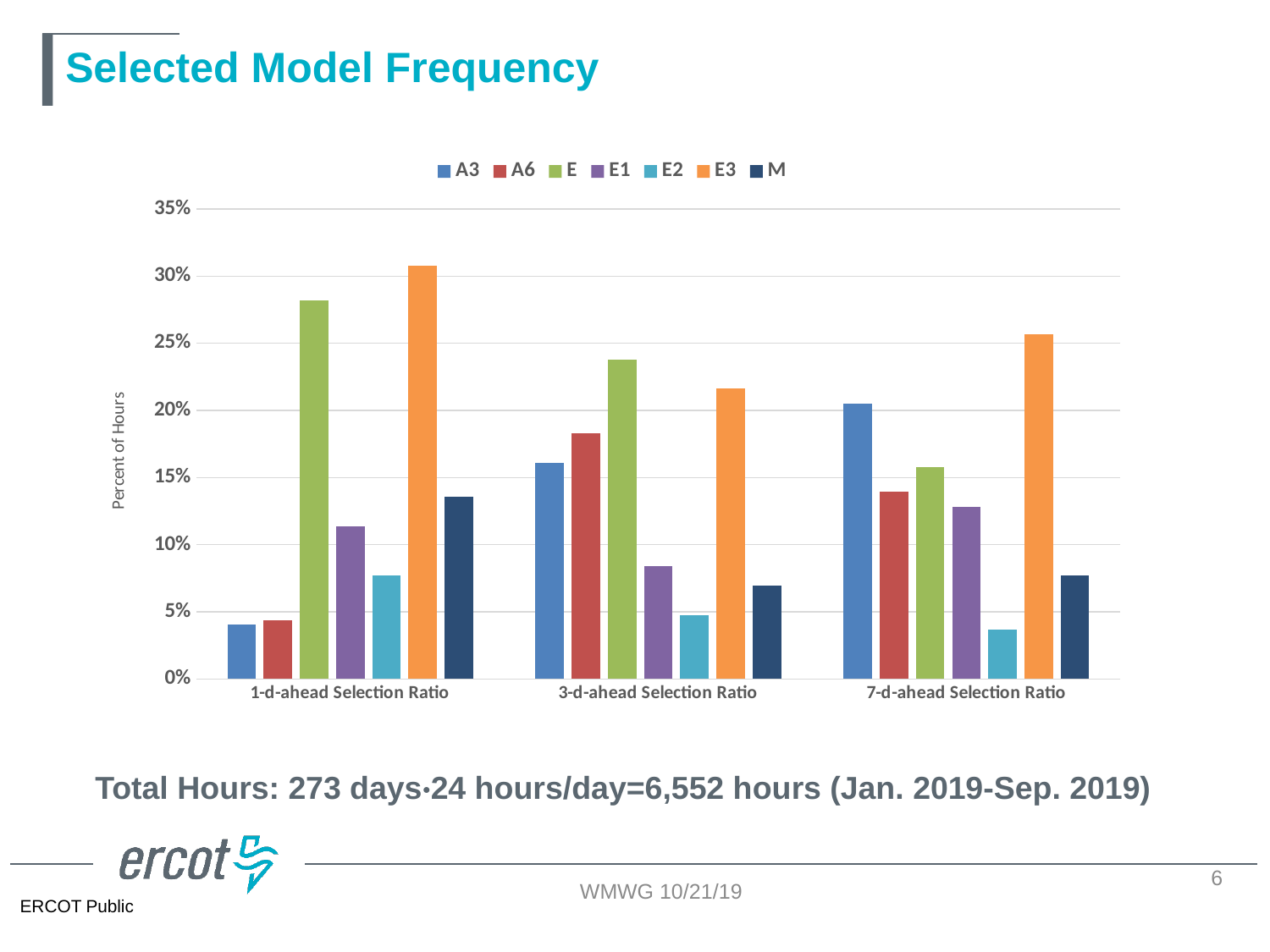
For 3-d-ahead Selection Ratio, which is larger, E or E3? E Which series has the highest value for 1-d-ahead Selection Ratio? E3 How many categories are shown on the x axis? 3 Which series has the lowest value for 7-d-ahead Selection Ratio? E2 What kind of chart is shown on the slide? bar chart Which series has the lowest value for 3-d-ahead Selection Ratio? E2 Is the value for M in the 1-d-ahead Selection Ratio greater or less than 15%? less Is the value for A6 in the 3-d-ahead Selection Ratio greater or less than 15%? greater Is the value for E in the 1-d-ahead Selection Ratio greater or less than 25%? greater How many series does the legend list? 7 What is the label on the y axis? Percent of Hours Does the value for A3 rise or fall from 1-d-ahead to 7-d-ahead Selection Ratio? rise